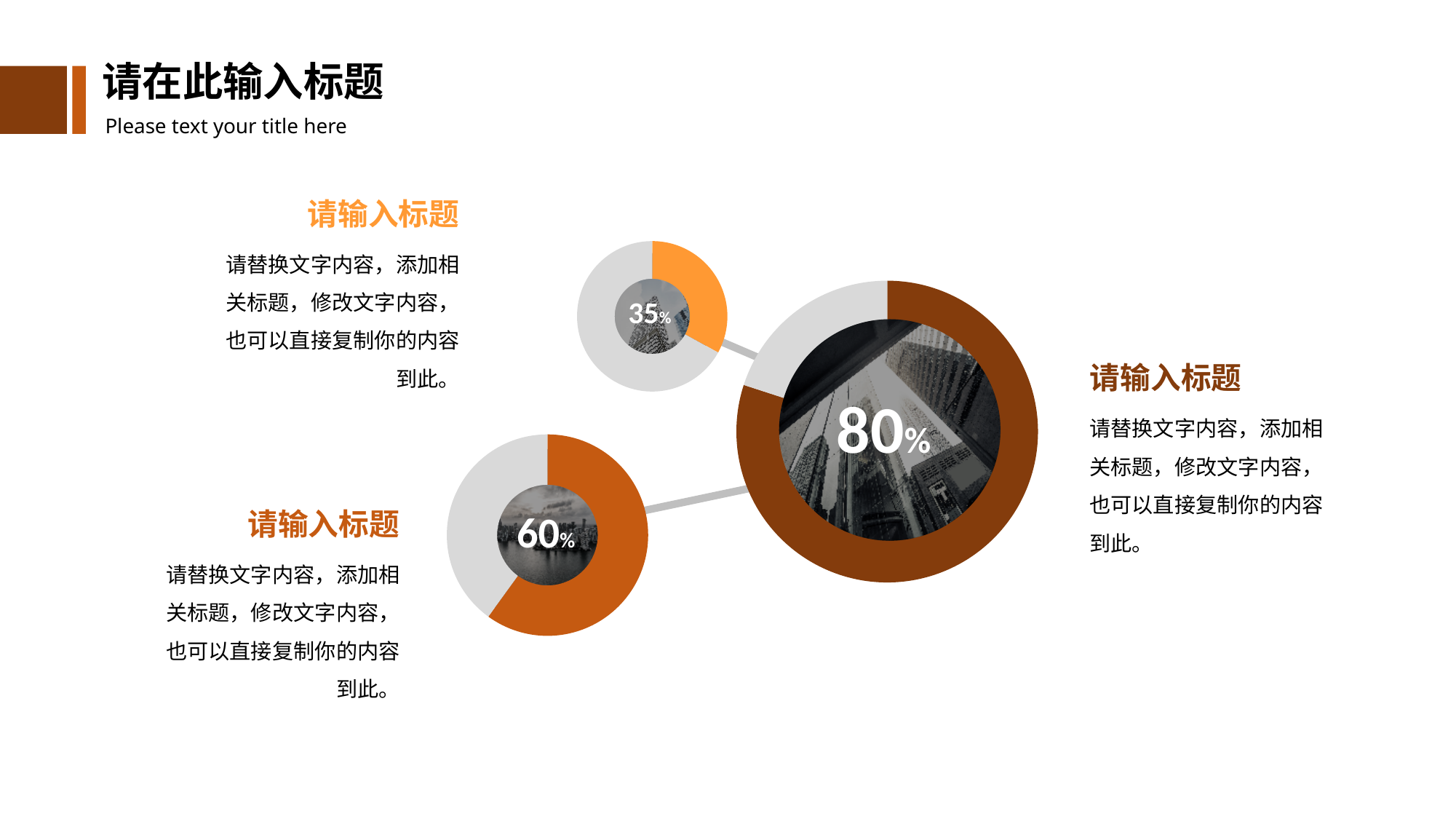
What colour is the filled portion of the small donut chart showing 35%? Orange What kind of chart is used to display the percentages on the slide? Donut chart What value is shown in the donut chart at the bottom left of the diagram? 60% What is the difference between the value in the bottom-left donut chart and the value in the top-left donut chart? 25% What value is shown in the small donut chart at the top left of the diagram? 35% Which is larger, the value in the top-left donut chart or the value in the bottom-left donut chart? The bottom-left donut chart (60%) Which donut chart shows the highest percentage? The large one on the right (80%) Which donut chart shows the lowest percentage? The small one at the top left (35%) What is the difference between the value in the large right donut chart and the value in the bottom-left donut chart? 20% What value is shown in the large donut chart on the right? 80% How many donut charts are shown on the slide? 3 What colour is the filled portion of the large donut chart showing 80%? Brown